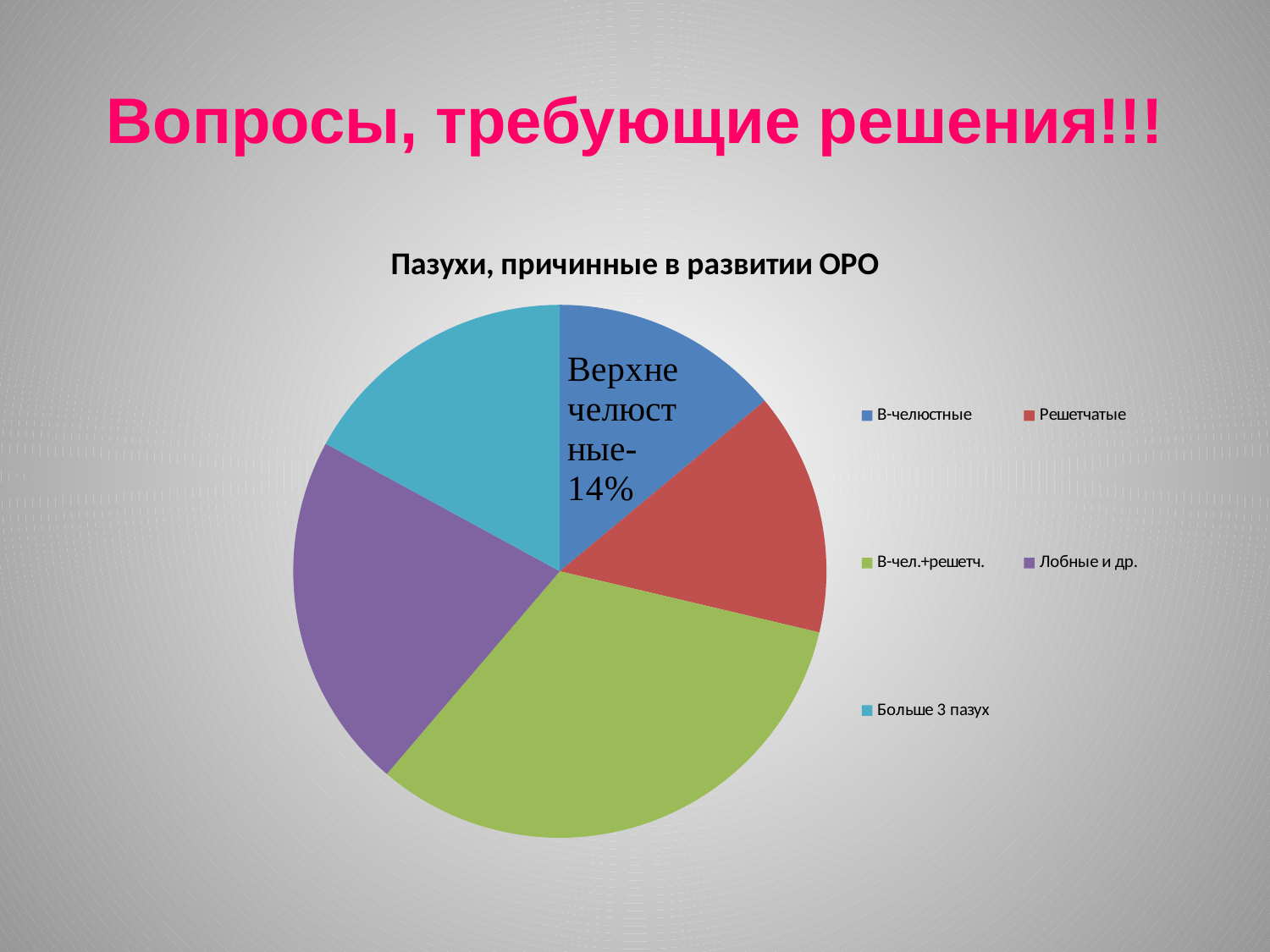
What is the title of the chart? Пазухи, причинные в развитии ОРО Which slice is larger, В-чел.+решетч. or В-челюстные? В-чел.+решетч. How many entries does the legend list? 5 Which slice is larger, Лобные и др. or В-челюстные? Лобные и др. Which colour represents the В-чел.+решетч. slice? green Which category has the largest slice of the pie? В-чел.+решетч. What kind of chart is shown on the slide? pie chart Which slice is larger, Лобные и др. or Решетчатые? Лобные и др. How many slices does the pie chart have? 5 What share of the pie is labelled for Верхнечелюстные (В-челюстные)? 14%